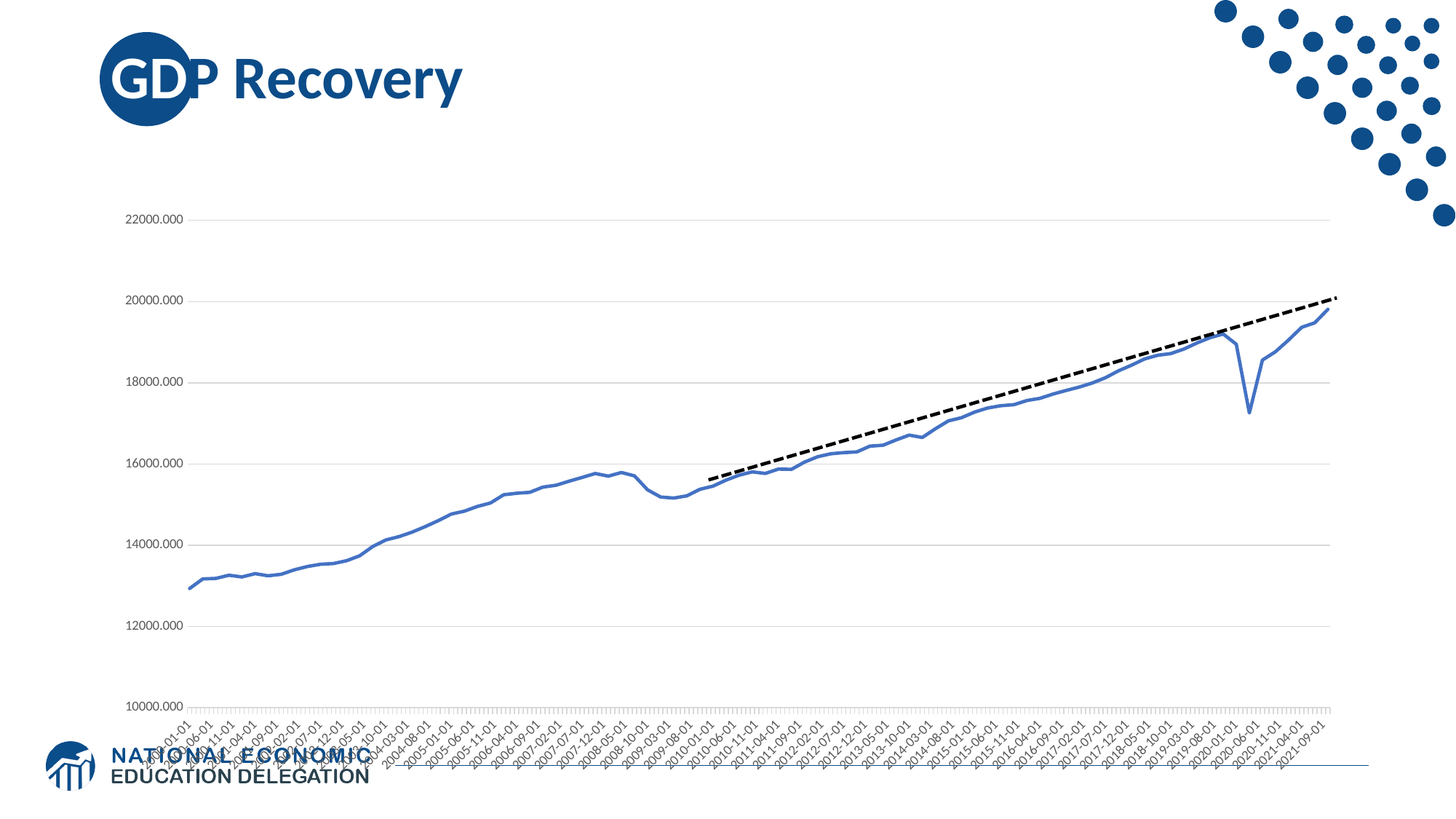
Is the value at 2001-01-01 greater or less than 12000.000? greater What is the title of the slide containing the chart? GDP Recovery What style is the black line drawn over the blue GDP line? Dashed Is the value at 2021-09-01 greater or less than 20000.000? less Is the value at 2020-06-01 greater or less than 16000.000? greater What kind of chart is shown on the slide? Line chart Which is larger, the value at 2008-05-01 or the value at 2009-08-01? 2008-05-01 Overall, do the plotted values rise or fall from 2001 to 2021 along the x axis? Rise